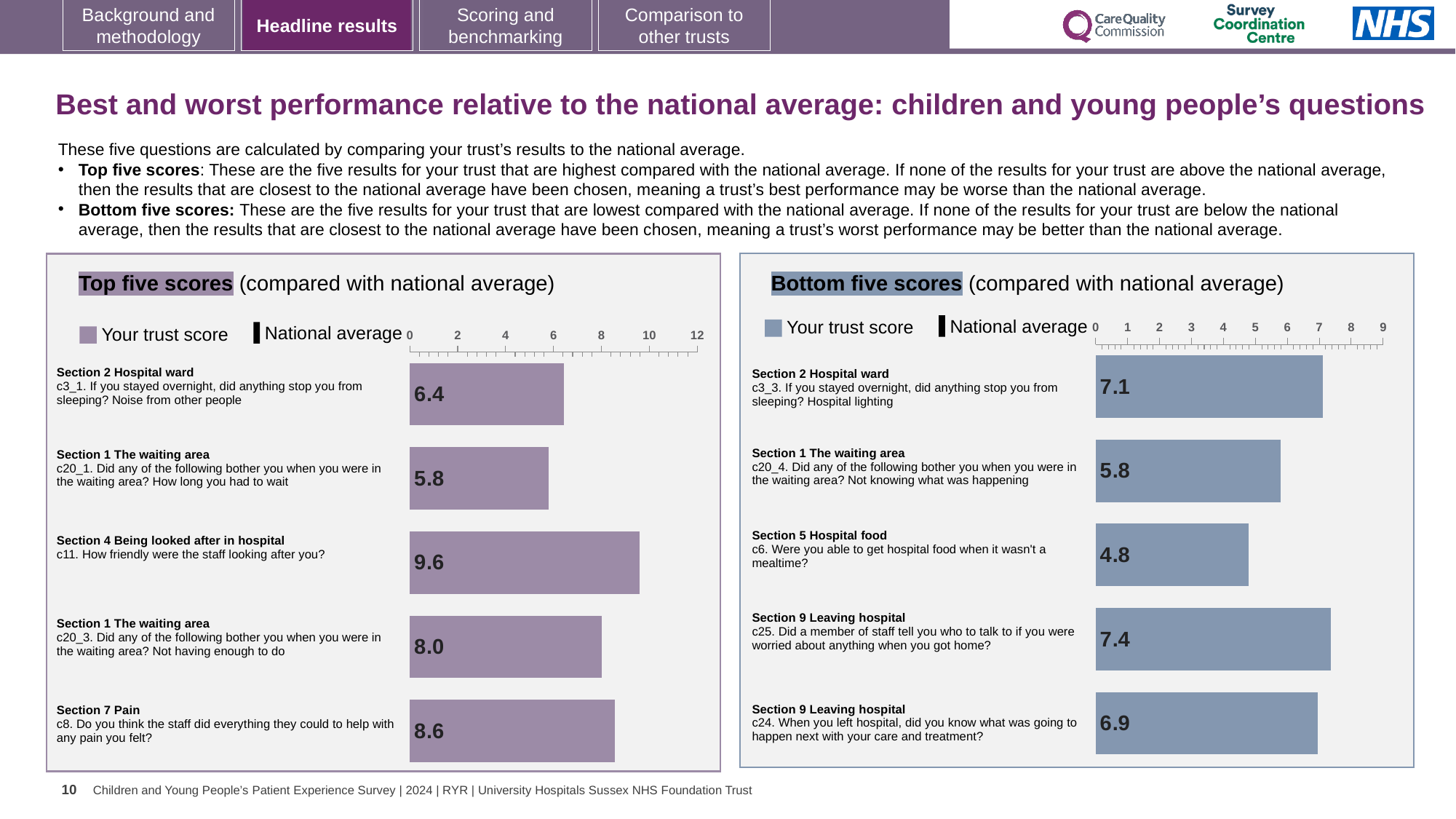
In the 'Bottom five scores' chart, what is the difference between the trust scores for c25 and c20_4? 1.6 In the 'Bottom five scores' chart, which has the larger trust score: c3_3 (hospital lighting) or c24 (knowing what was going to happen next)? c3_3 (hospital lighting) In the 'Bottom five scores' chart, what is the trust score for c6 'Were you able to get hospital food when it wasn't a mealtime?' 4.8 What kind of chart is used in the 'Top five scores' panel? Bar chart In the 'Bottom five scores' chart, which question has the lowest trust score? c6. Were you able to get hospital food when it wasn't a mealtime? In the 'Top five scores' chart, what is the difference between the trust scores for c8 (pain) and c3_1 (noise from other people)? 2.2 In the 'Top five scores' chart, how many questions are plotted? 5 In the 'Top five scores' chart, which question has the highest trust score? c11. How friendly were the staff looking after you? In the 'Bottom five scores' chart, what is the trust score for c25 'Did a member of staff tell you who to talk to if you were worried about anything when you got home?' 7.4 In the 'Top five scores' chart, what is the trust score for c20_1 'How long you had to wait'? 5.8 How many entries does the legend of the 'Bottom five scores' chart list? 2 In the 'Top five scores' chart, what is the trust score for c11 'How friendly were the staff looking after you?' 9.6